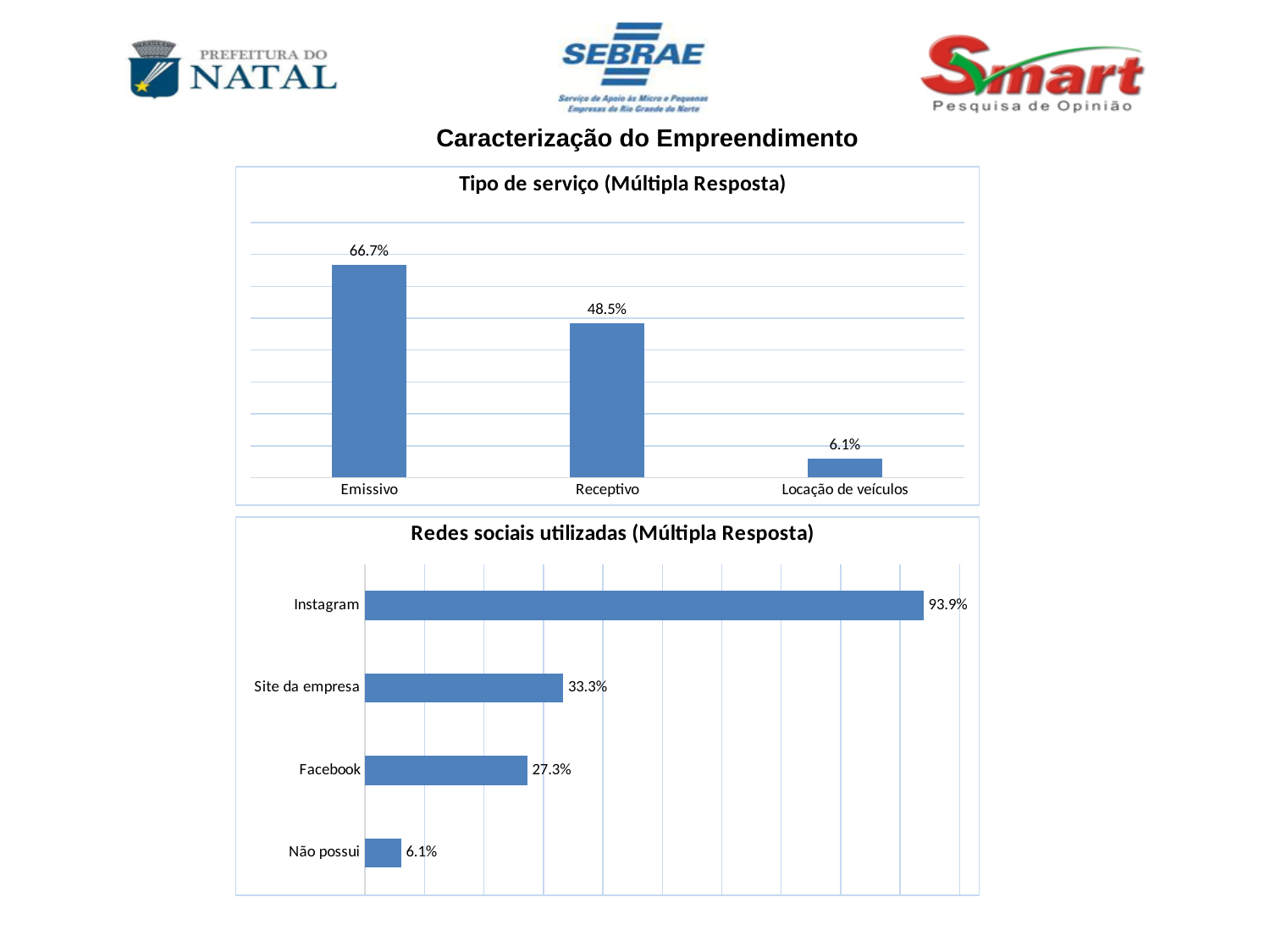
In the 'Tipo de serviço (Múltipla Resposta)' chart, what is the value for Emissivo? 66.7% In the 'Tipo de serviço (Múltipla Resposta)' chart, which category has the lowest value? Locação de veículos What kind of chart is 'Tipo de serviço (Múltipla Resposta)'? Bar chart In the 'Redes sociais utilizadas (Múltipla Resposta)' chart, what is the difference between Site da empresa and Facebook? 6.0% In the 'Redes sociais utilizadas (Múltipla Resposta)' chart, what is the value for Facebook? 27.3% In the 'Redes sociais utilizadas (Múltipla Resposta)' chart, which is larger: Site da empresa or Facebook? Site da empresa In the 'Redes sociais utilizadas (Múltipla Resposta)' chart, which category has the highest value? Instagram In the 'Tipo de serviço (Múltipla Resposta)' chart, what is the difference between Emissivo and Receptivo? 18.2% In the 'Tipo de serviço (Múltipla Resposta)' chart, what is the value for Receptivo? 48.5% In the 'Tipo de serviço (Múltipla Resposta)' chart, how many categories are shown? 3 In the 'Redes sociais utilizadas (Múltipla Resposta)' chart, what is the value for Instagram? 93.9% In the 'Redes sociais utilizadas (Múltipla Resposta)' chart, how many categories are shown? 4